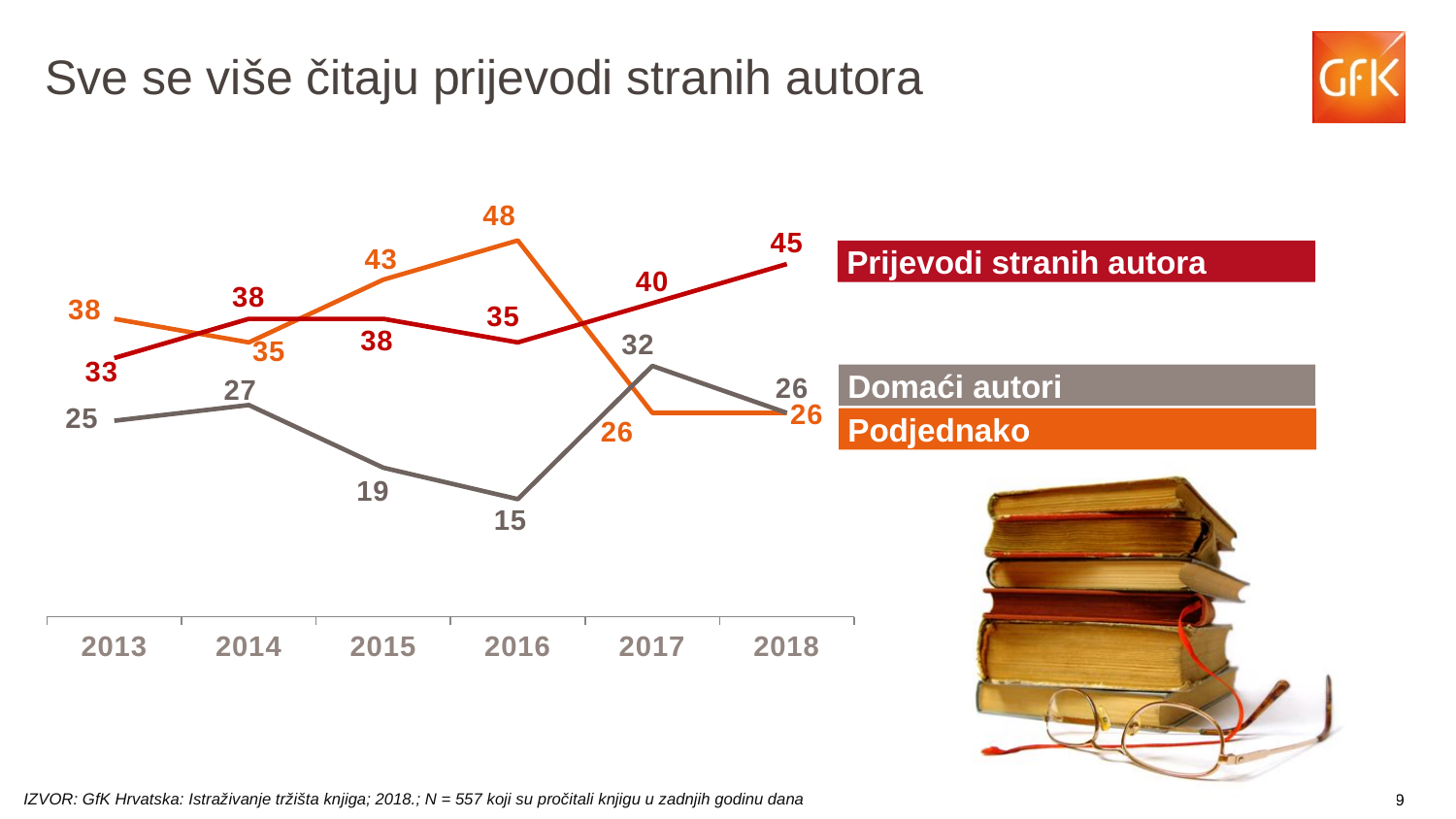
What is the value for Domaći autori in 2016? 15 Does the value for Prijevodi stranih autora rise or fall from 2016 to 2018? rise How many series does the chart show? 3 Which series is drawn in orange? Podjednako What kind of chart is shown on the slide? line chart Which series has the higher value in 2015, Podjednako or Prijevodi stranih autora? Podjednako In which year is the value for Domaći autori lowest? 2016 What is the value for Prijevodi stranih autora in 2018? 45 What is the value for Podjednako in 2016? 48 How many years are shown on the x axis? 6 What is the difference between Prijevodi stranih autora and Domaći autori in 2018? 19 In which year is the value for Podjednako highest? 2016